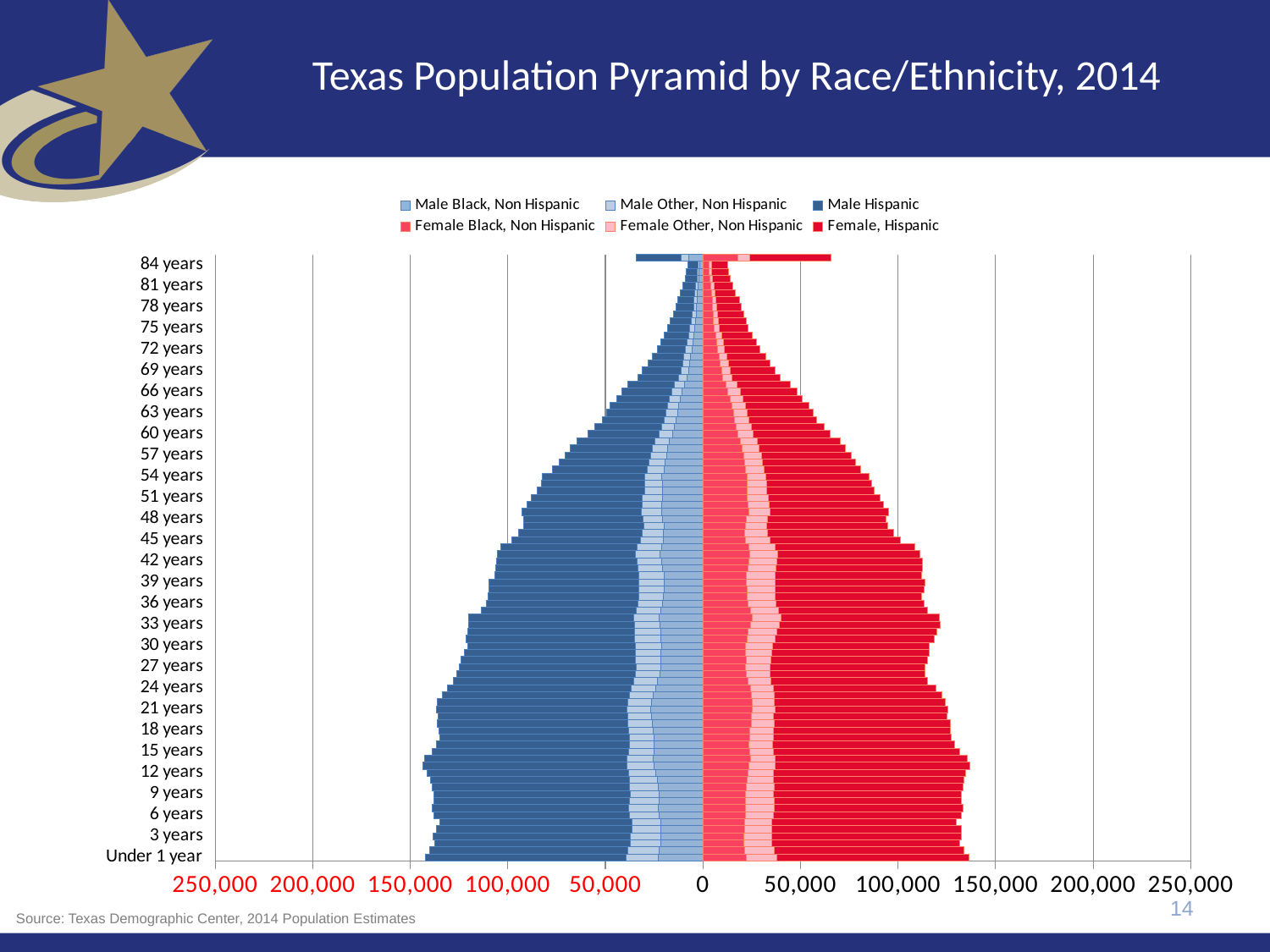
Do the bars generally get shorter or longer as age increases from Under 1 year to 84 years? Shorter Is the total female bar for 60 years greater or less than 150,000? less Which is larger, the total male bar for 12 years or the total male bar for 84 years? 12 years At 84 years, which total bar is longer, the male side or the female side? Female What is the title of the chart? Texas Population Pyramid by Race/Ethnicity, 2014 Is the total male bar for 12 years greater or less than 100,000? greater Which legend entry is shown in dark blue? Male Hispanic How many series does the legend list? 6 Is the total female bar for 12 years greater or less than 100,000? greater What kind of chart is shown on the slide? Bar chart (population pyramid)